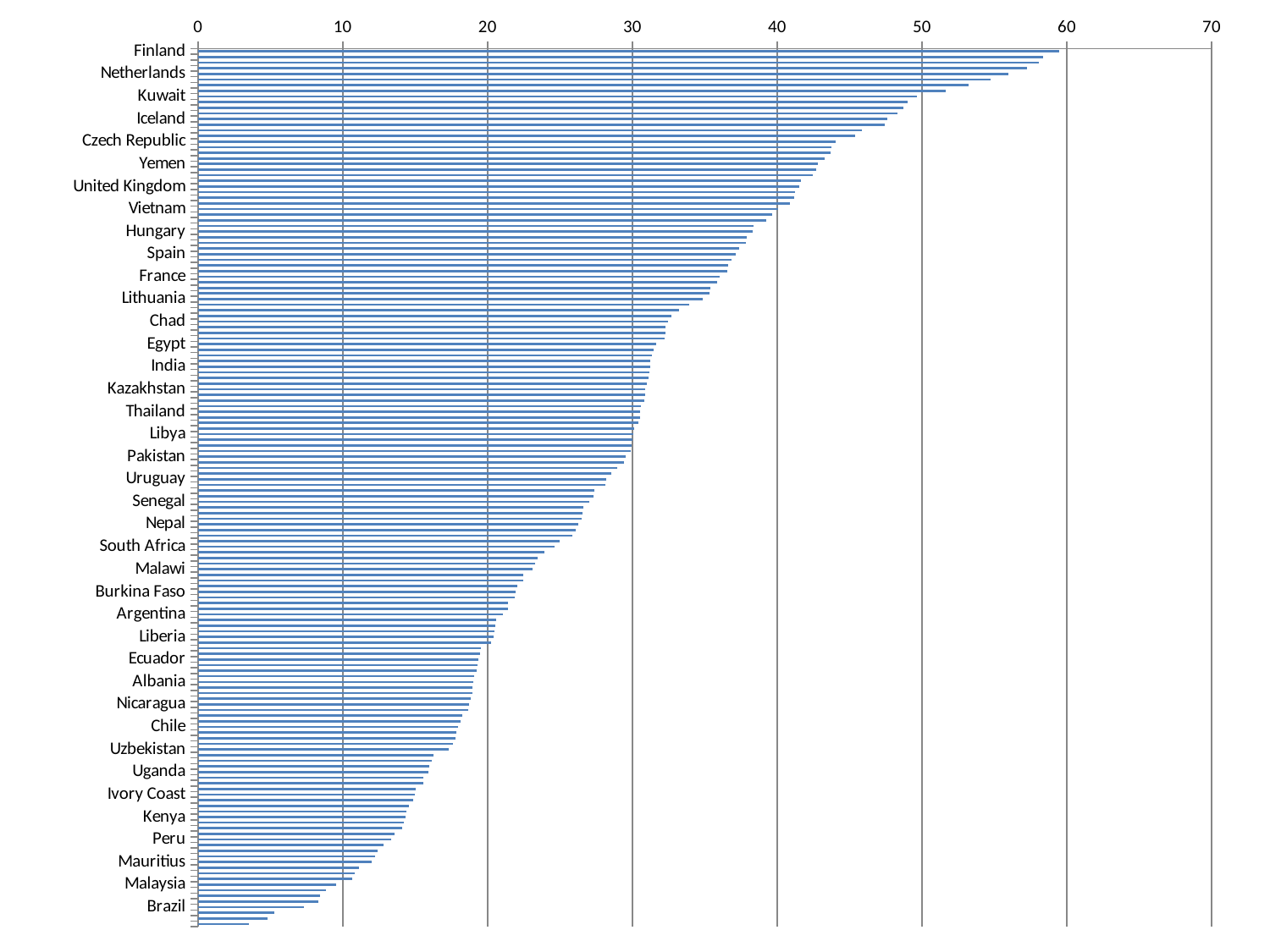
Is the value for Iceland greater or less than 40? greater Is the value for Chile greater or less than 20? less Is the value for Kenya greater or less than 10? greater Do the bar values increase or decrease going from the top of the chart to the bottom? decrease What kind of chart is shown on the slide? bar chart Which country has the highest value in the chart? Finland Among the labeled countries, which has the lowest value? Brazil Which has the larger value, Netherlands or Spain? Netherlands